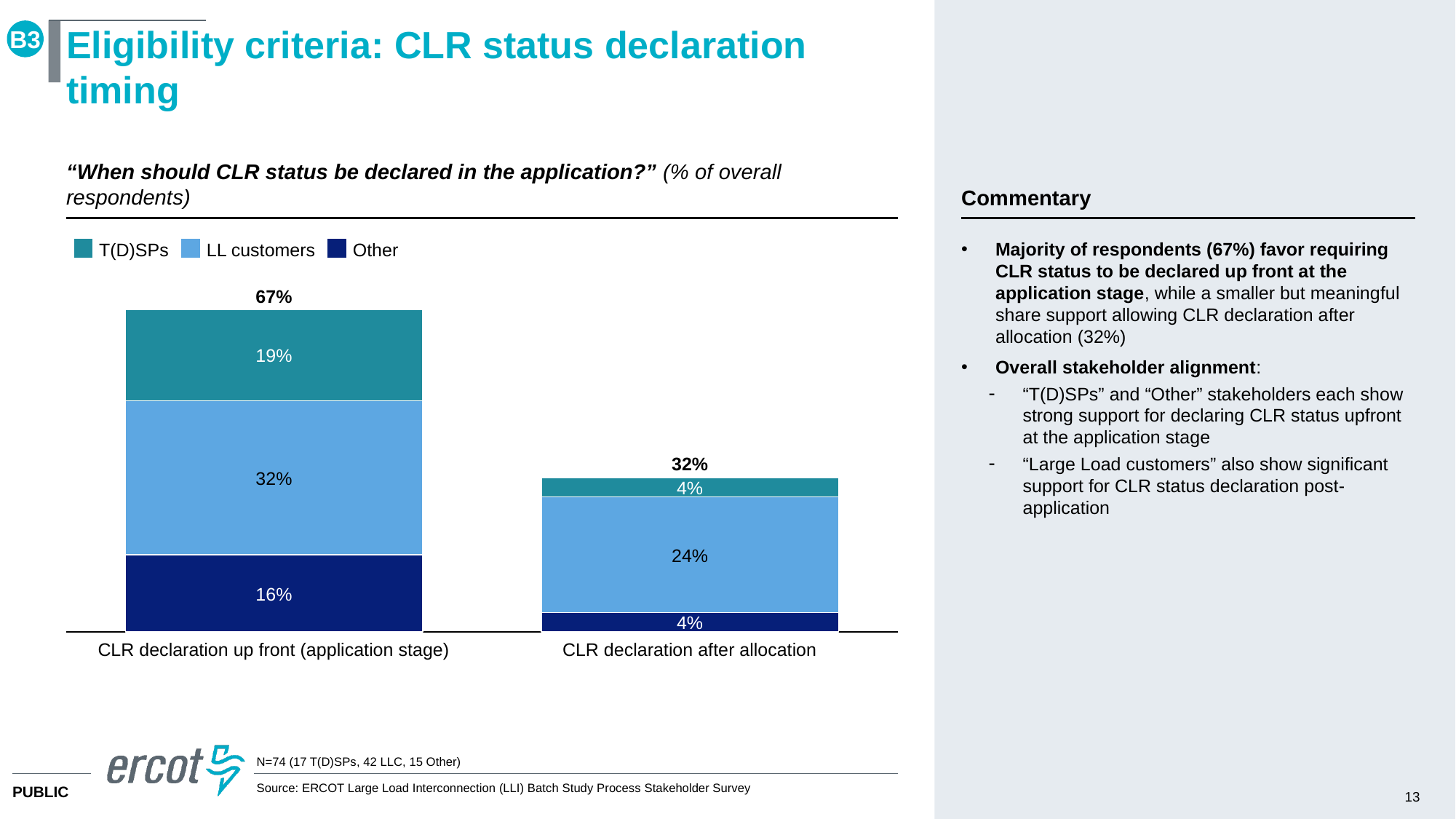
How many categories are shown on the x axis? 2 What is the value for Other in the 'CLR declaration up front (application stage)' bar? 16% What is the value for LL customers in the 'CLR declaration up front (application stage)' bar? 32% How many series does the legend list? 3 Which category has the higher total, 'CLR declaration up front (application stage)' or 'CLR declaration after allocation'? CLR declaration up front (application stage) What is the value for T(D)SPs in the 'CLR declaration after allocation' bar? 4% Which series has the largest segment in the 'CLR declaration after allocation' bar? LL customers What is the difference between the LL customers values for 'CLR declaration up front (application stage)' and 'CLR declaration after allocation'? 8% What are the three legend entries of the chart? T(D)SPs, LL customers, Other What kind of chart is shown on the slide? Stacked bar chart What is the total for the 'CLR declaration up front (application stage)' bar? 67% What is the total for the 'CLR declaration after allocation' bar? 32%